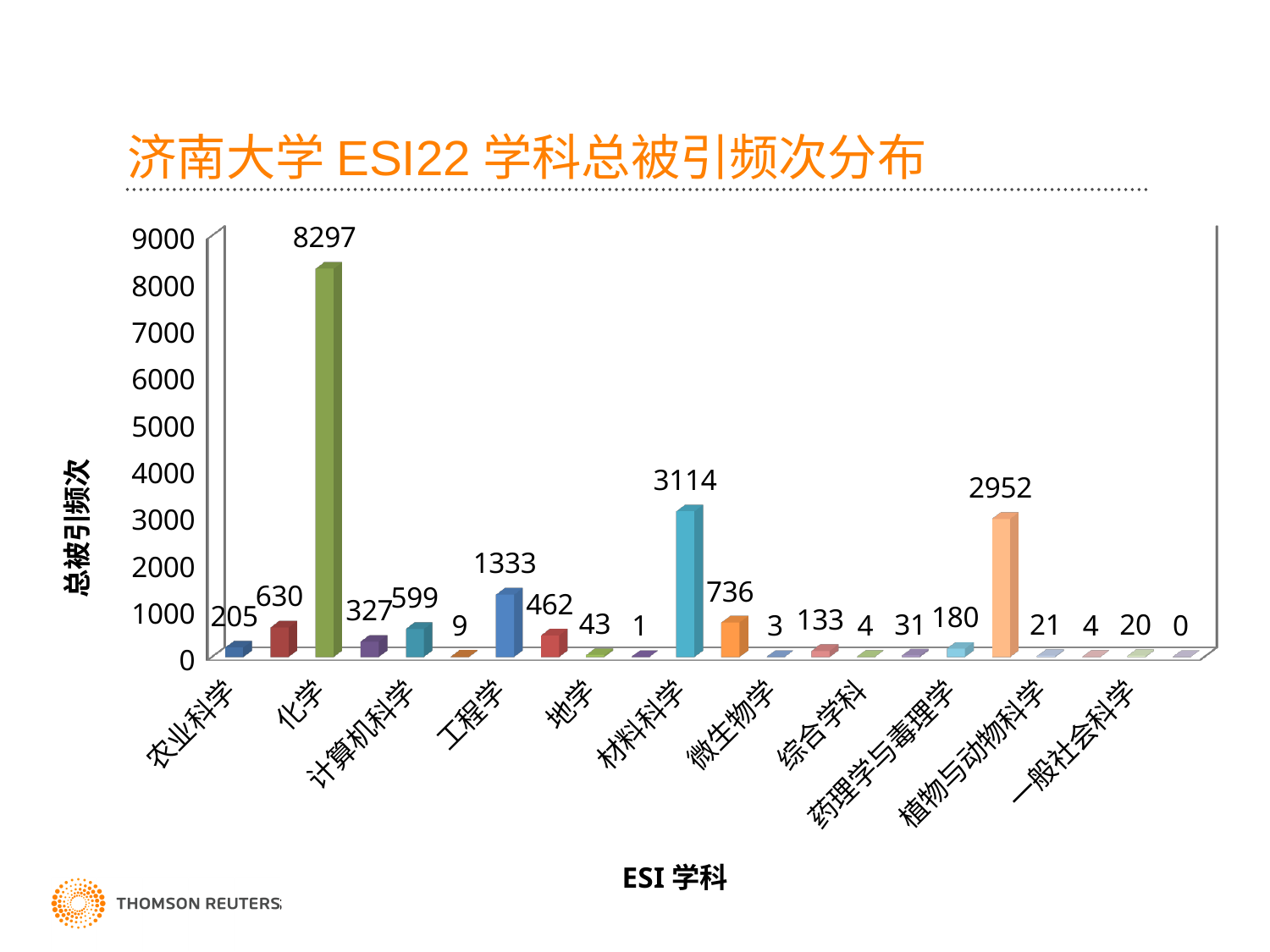
What is the label of the vertical axis? 总被引频次 What is the value shown for 材料科学? 3114 What kind of chart is shown on the slide? Bar chart What is the value shown for 工程学? 1333 What is the lowest value labeled on any bar in the chart? 0 Which discipline has the highest total citation count? 化学 What is the value shown for 植物与动物科学? 21 What is the value shown for 农业科学? 205 Which has a larger value, 工程学 or 药理学与毒理学? 工程学 What is the difference between the values for 材料科学 and 植物与动物科学? 3093 How many bars are plotted in the chart? 22 What is the total citation count (总被引频次) for 化学? 8297